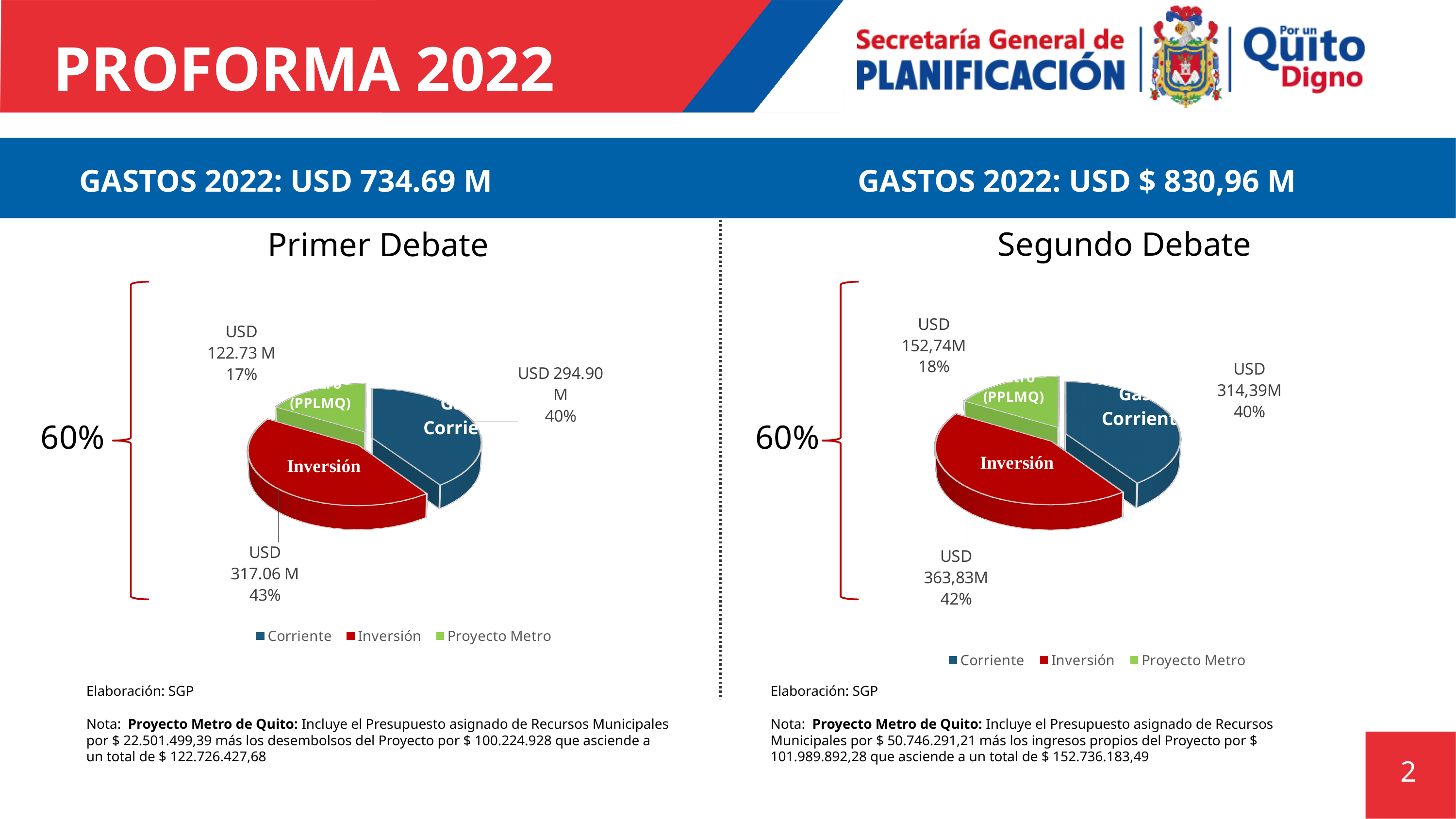
In the Primer Debate chart, which category has the largest slice? Inversión In the Segundo Debate chart, what is the difference in percentage points between Inversión and Proyecto Metro? 24 percentage points How many categories does the Primer Debate chart show? 3 In the Segundo Debate chart, what share of the pie does Corriente represent? 40% In the Segundo Debate chart, what is the value for Inversión? USD 363,83M In the Segundo Debate chart, what is the value for Proyecto Metro? USD 152,74M What kind of chart is the Segundo Debate chart? Pie chart In the Primer Debate chart, what is the value for Corriente? USD 294.90 M In the Segundo Debate chart, which category has the smallest slice? Proyecto Metro In the Primer Debate chart, what share of the pie does Proyecto Metro represent? 17% In the Primer Debate chart, what is the value for Inversión? USD 317.06 M In the Primer Debate chart, which is larger, Corriente or Proyecto Metro? Corriente